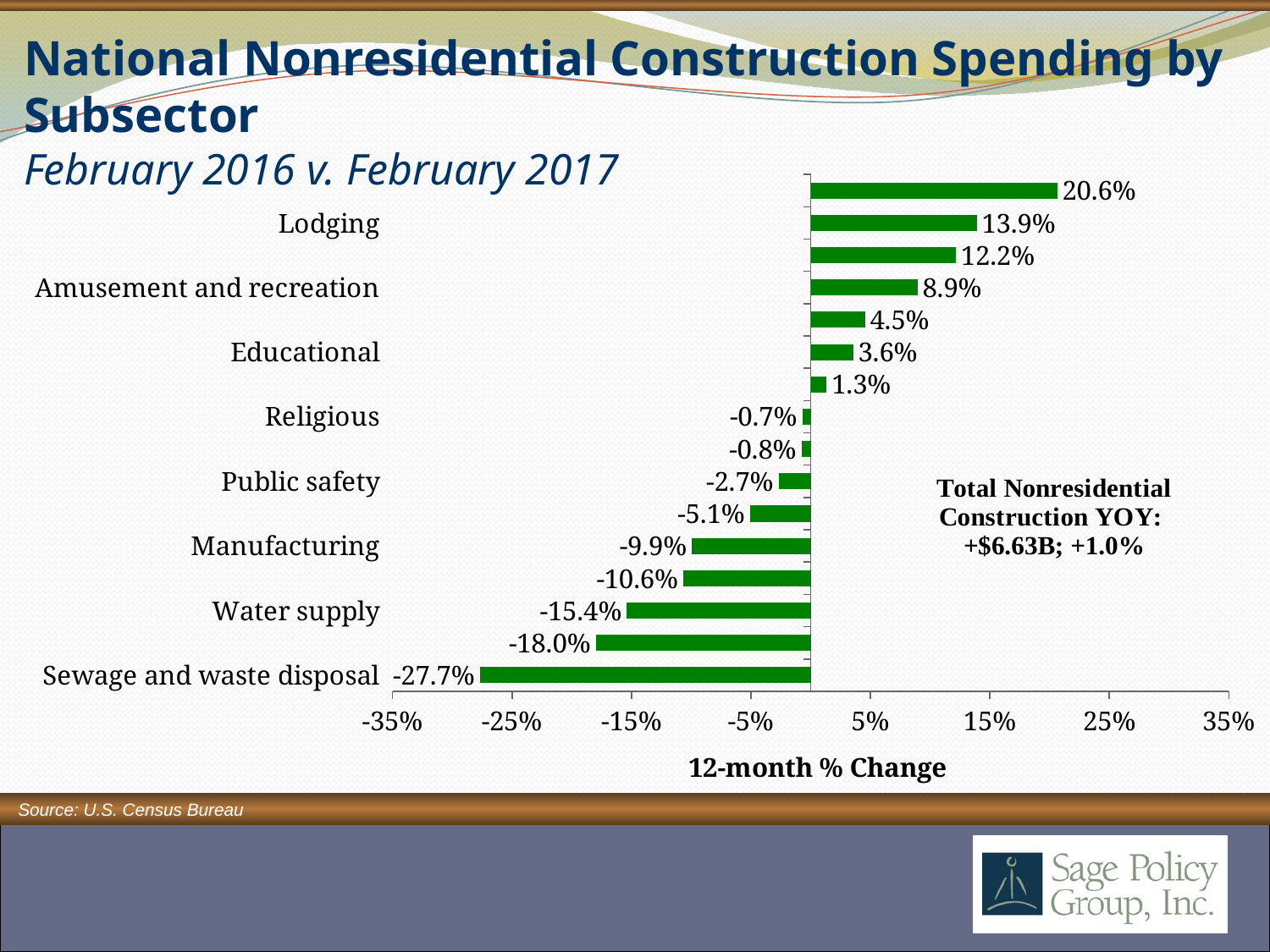
What is the x-axis title of the chart? 12-month % Change How many bars are plotted on the chart? 16 Which has a larger 12-month % change, Religious or Public safety? Religious Is the value for Water supply greater or less than -5%? less What is the difference between the 12-month % change for Lodging and for Educational? 10.3 percentage points What is the largest 12-month % change shown on the chart? 20.6% What is the 12-month % change for Lodging? 13.9% What is the 12-month % change for Sewage and waste disposal? -27.7% What is the 12-month % change for Manufacturing? -9.9% What is the 12-month % change for Amusement and recreation? 8.9% What kind of chart is shown on the slide? Bar chart Which labeled subsector has the lowest 12-month % change? Sewage and waste disposal